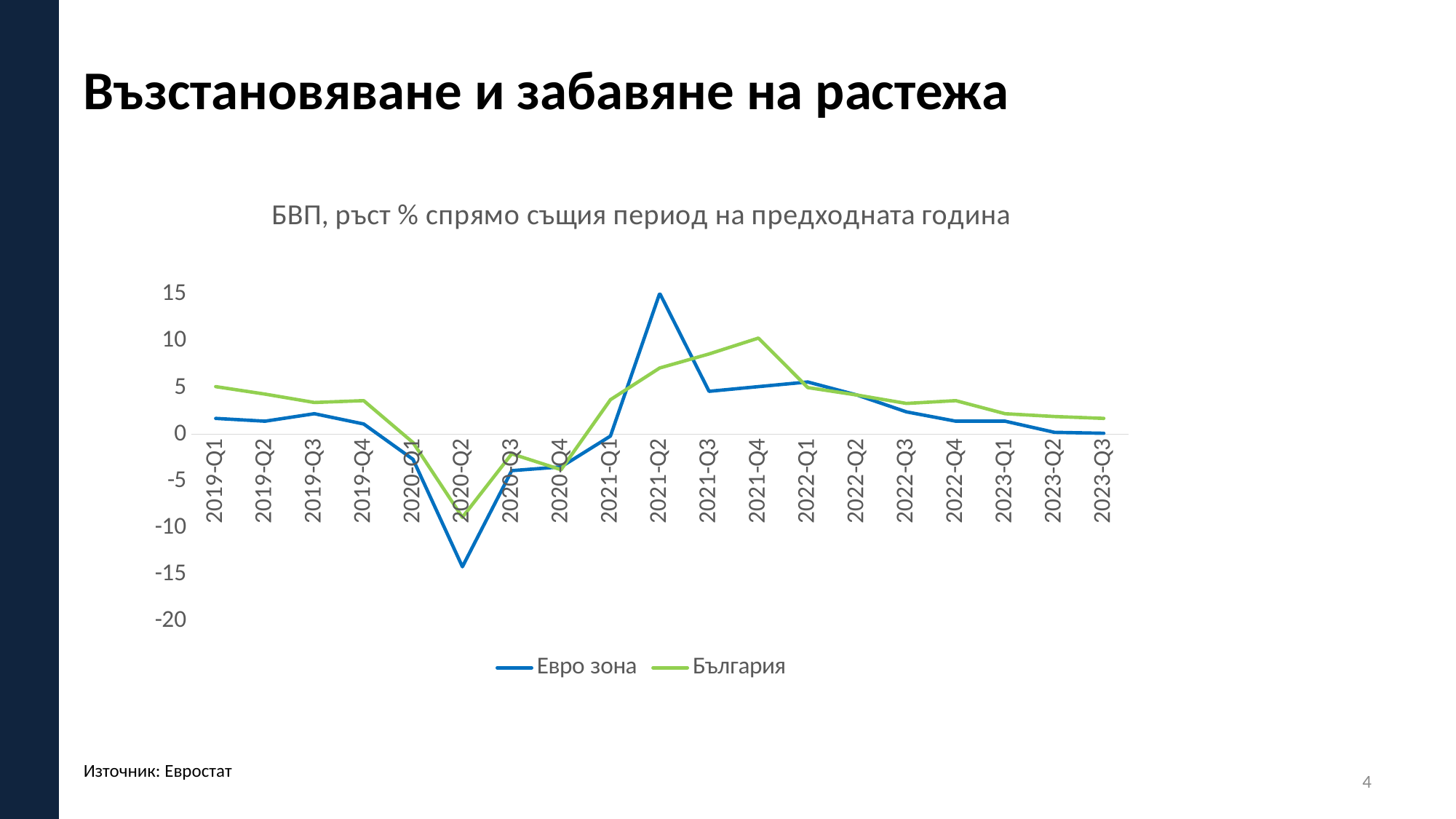
Is the value for България in 2021-Q2 greater or less than 5? greater How many quarters are plotted along the x axis? 19 What is the title of the chart? БВП, ръст % спрямо същия период на предходната година Does the Евро зона series rise or fall from 2021-Q2 to 2023-Q3? Fall Is the value for Евро зона in 2020-Q2 greater or less than -10? less In 2021-Q4, which series has the higher value, Евро зона or България? България How many series does the legend list? 2 In which quarter does the Евро зона series reach its lowest value? 2020-Q2 In which quarter does the Евро зона series reach its highest value? 2021-Q2 In which quarter does the България series reach its highest value? 2021-Q4 Is the value for Евро зона in 2021-Q2 greater or less than 10? greater What kind of chart is shown on the slide? Line chart